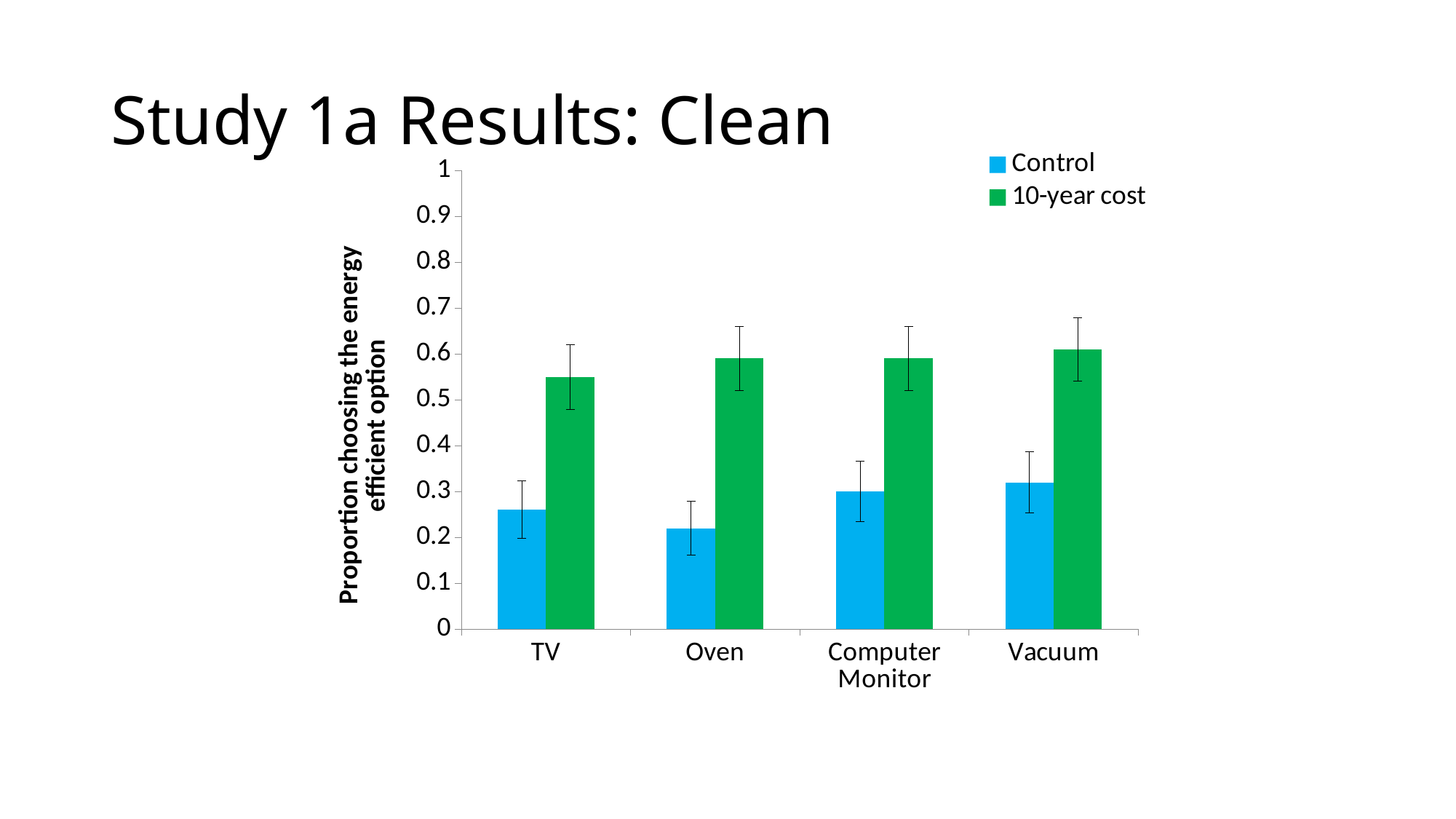
Is the 10-year cost value for Computer Monitor greater or less than 0.7? less Is the Control value for TV greater or less than 0.3? less For Oven, which is larger: Control or 10-year cost? 10-year cost How many series does the legend list? 2 Which category has the lowest Control value? Oven Which series is shown in green? 10-year cost How many categories are shown on the x axis? 4 Which category has the lowest 10-year cost value? TV What kind of chart is shown on the slide? bar chart What is the label of the y axis? Proportion choosing the energy efficient option Is the 10-year cost value for Oven greater or less than 0.5? greater For TV, which is larger: Control or 10-year cost? 10-year cost